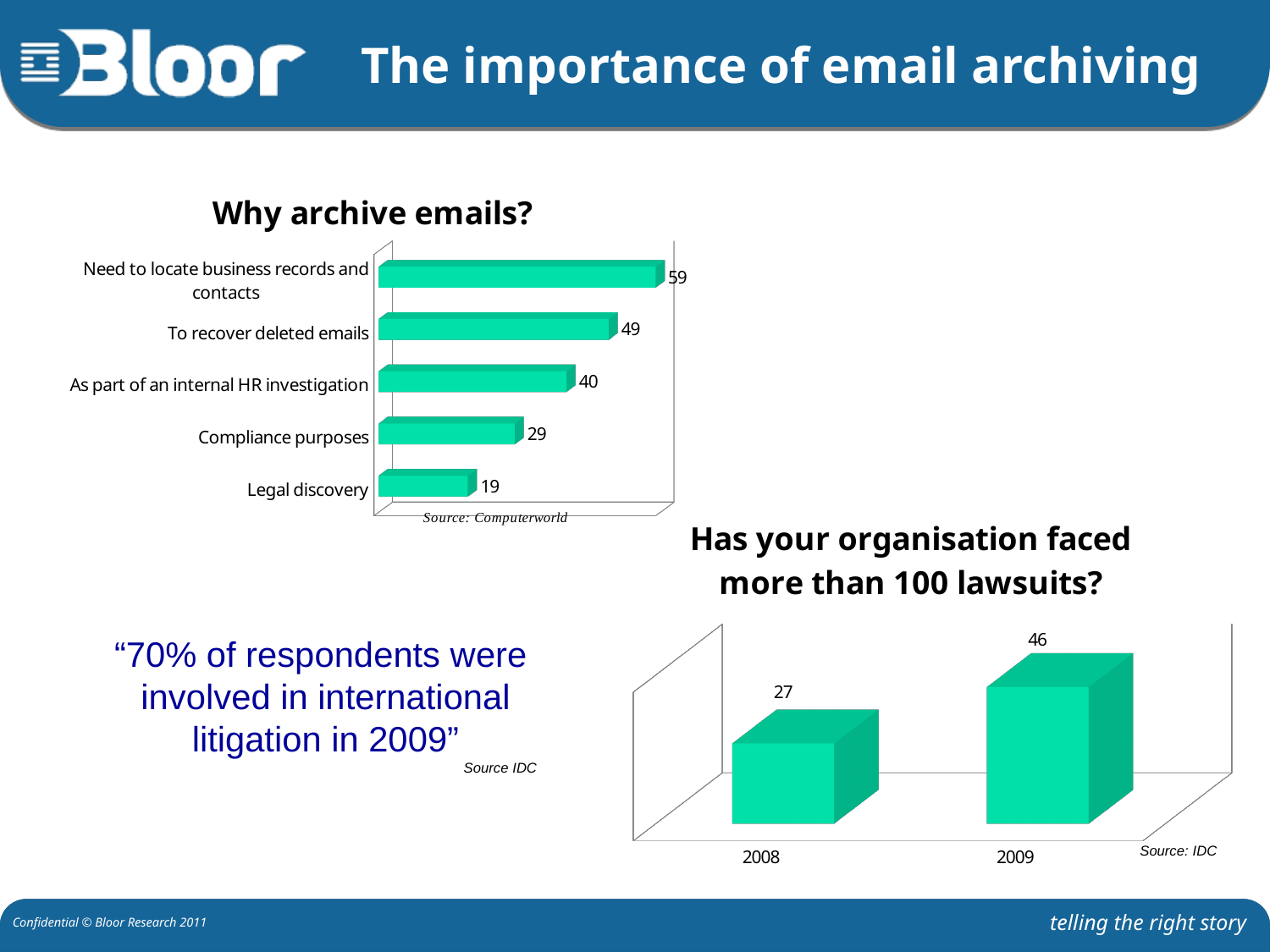
In the 'Why archive emails?' chart, what is the value for 'To recover deleted emails'? 49 In the 'Has your organisation faced more than 100 lawsuits?' chart, what is the value for 2009? 46 In the 'Has your organisation faced more than 100 lawsuits?' chart, what is the value for 2008? 27 In the 'Why archive emails?' chart, which category has the highest value? Need to locate business records and contacts What kind of chart is the 'Why archive emails?' chart? Bar chart In the 'Why archive emails?' chart, what is the value for 'Compliance purposes'? 29 In the 'Why archive emails?' chart, what is the difference between 'As part of an internal HR investigation' and 'Legal discovery'? 21 In the 'Why archive emails?' chart, which category has the lowest value? Legal discovery In the 'Has your organisation faced more than 100 lawsuits?' chart, what is the difference between 2009 and 2008? 19 In the 'Why archive emails?' chart, how many categories are shown? 5 In the 'Has your organisation faced more than 100 lawsuits?' chart, do the values rise or fall from 2008 to 2009? Rise What source is cited for the 'Why archive emails?' chart? Computerworld